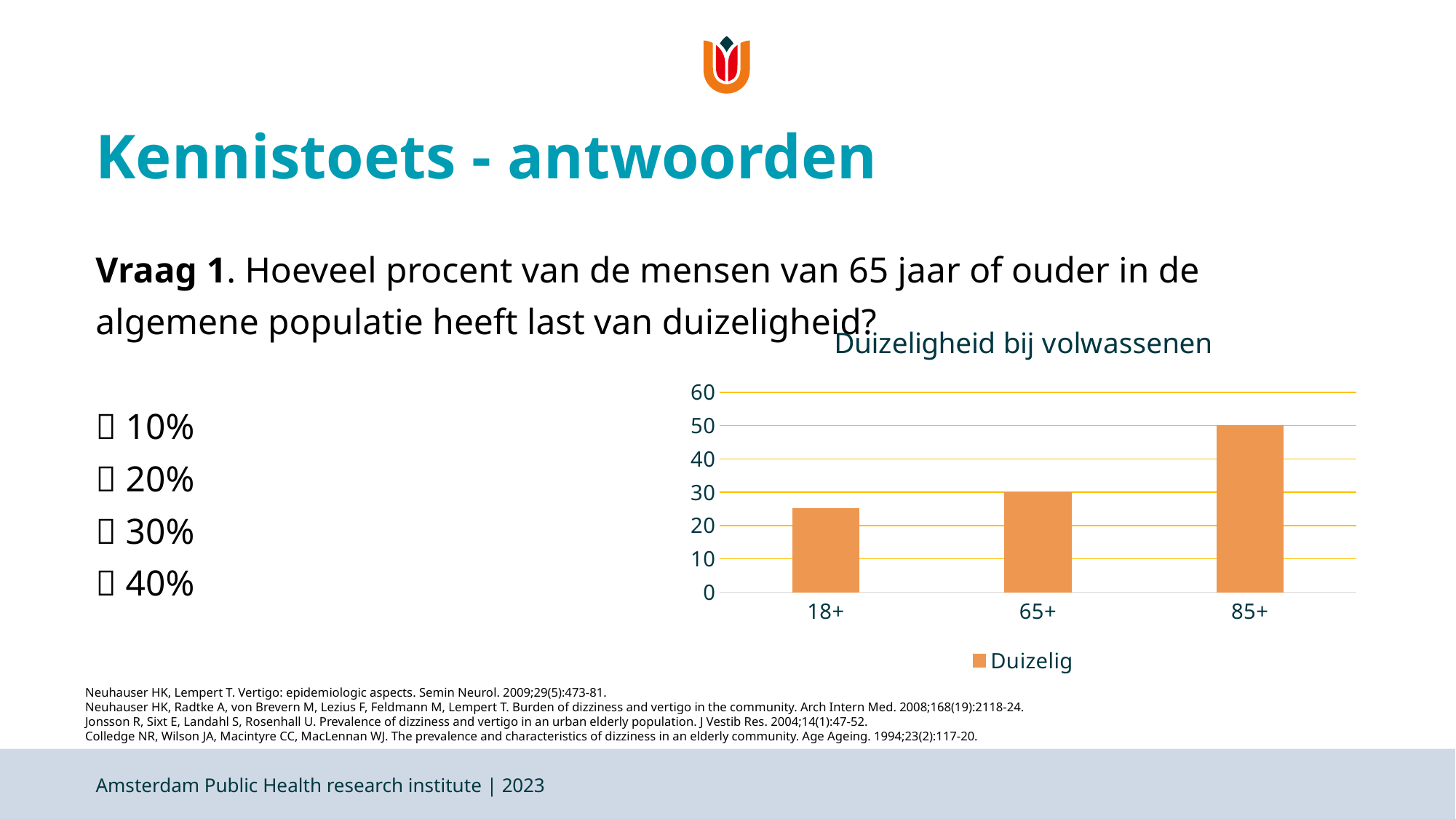
What is the difference between the values for 85+ and 65+? 20 Is the value for 18+ greater or less than 30? less What is the value for the 85+ category? 50 How many series does the chart legend list? 1 What is the title of the chart? Duizeligheid bij volwassenen Which age category has the highest value? 85+ What is the value for the 65+ category? 30 What type of chart is shown on the slide? bar chart How many age categories are shown on the x axis of the chart? 3 What is the name of the series in the chart legend? Duizelig Is the value for 18+ greater or less than 20? greater Which age category has the lowest value? 18+